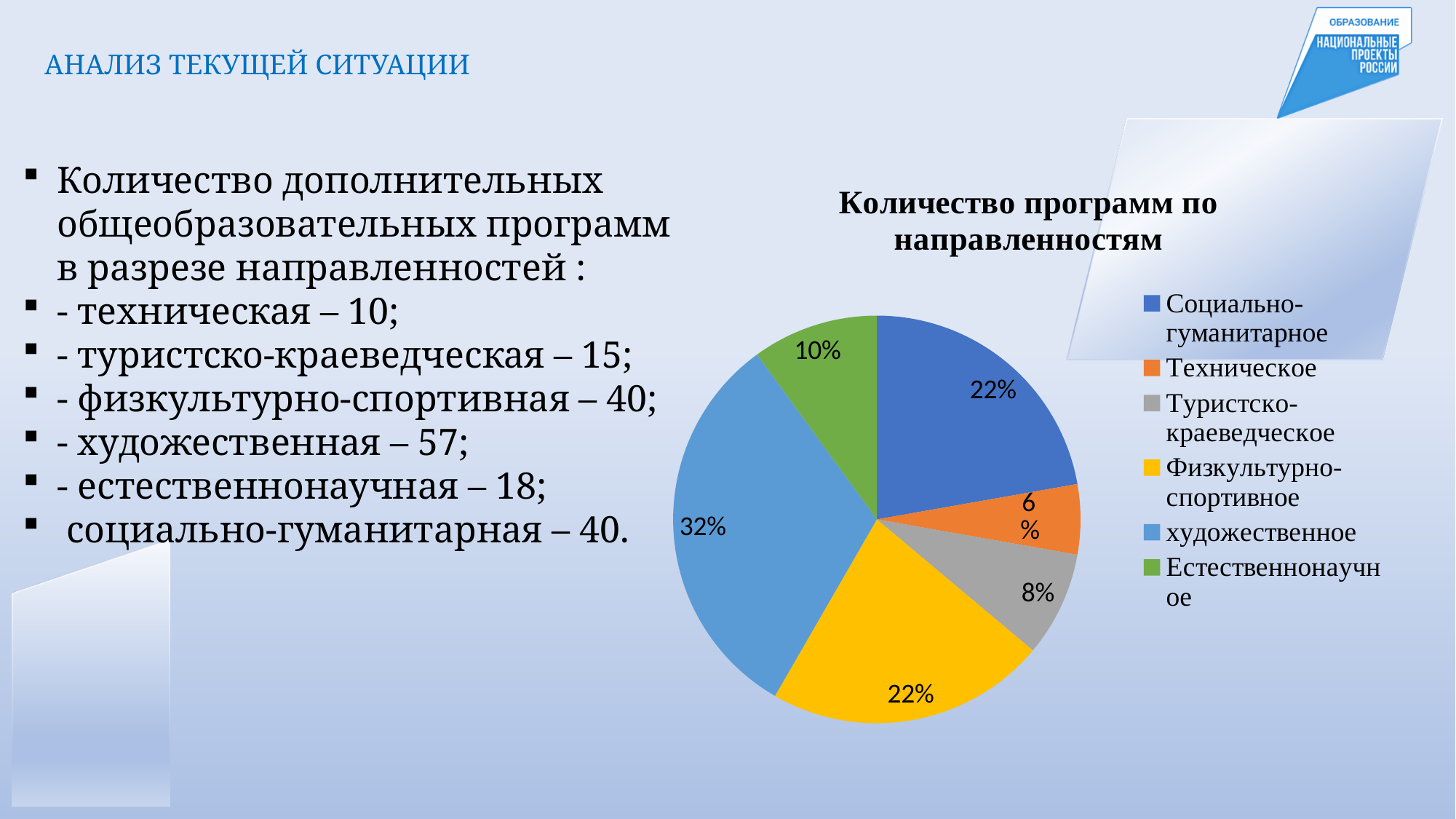
What kind of chart is shown on the slide? pie chart Which category has the smallest slice of the pie? Техническое Which is larger, the slice for Туристско-краеведческое or the slice for Техническое? Туристско-краеведческое What percentage is shown for Социально-гуманитарное? 22% How many slices does the pie chart have? 6 What is the title of the chart? Количество программ по направленностям What percentage is shown for Туристско-краеведческое? 8% What is the difference in percentage points between художественное and Физкультурно-спортивное? 10 What percentage is shown for Техническое? 6% What share of the pie does the художественное slice take? 32% What percentage is shown for Естественнонаучное? 10% Which category has the largest slice of the pie? художественное